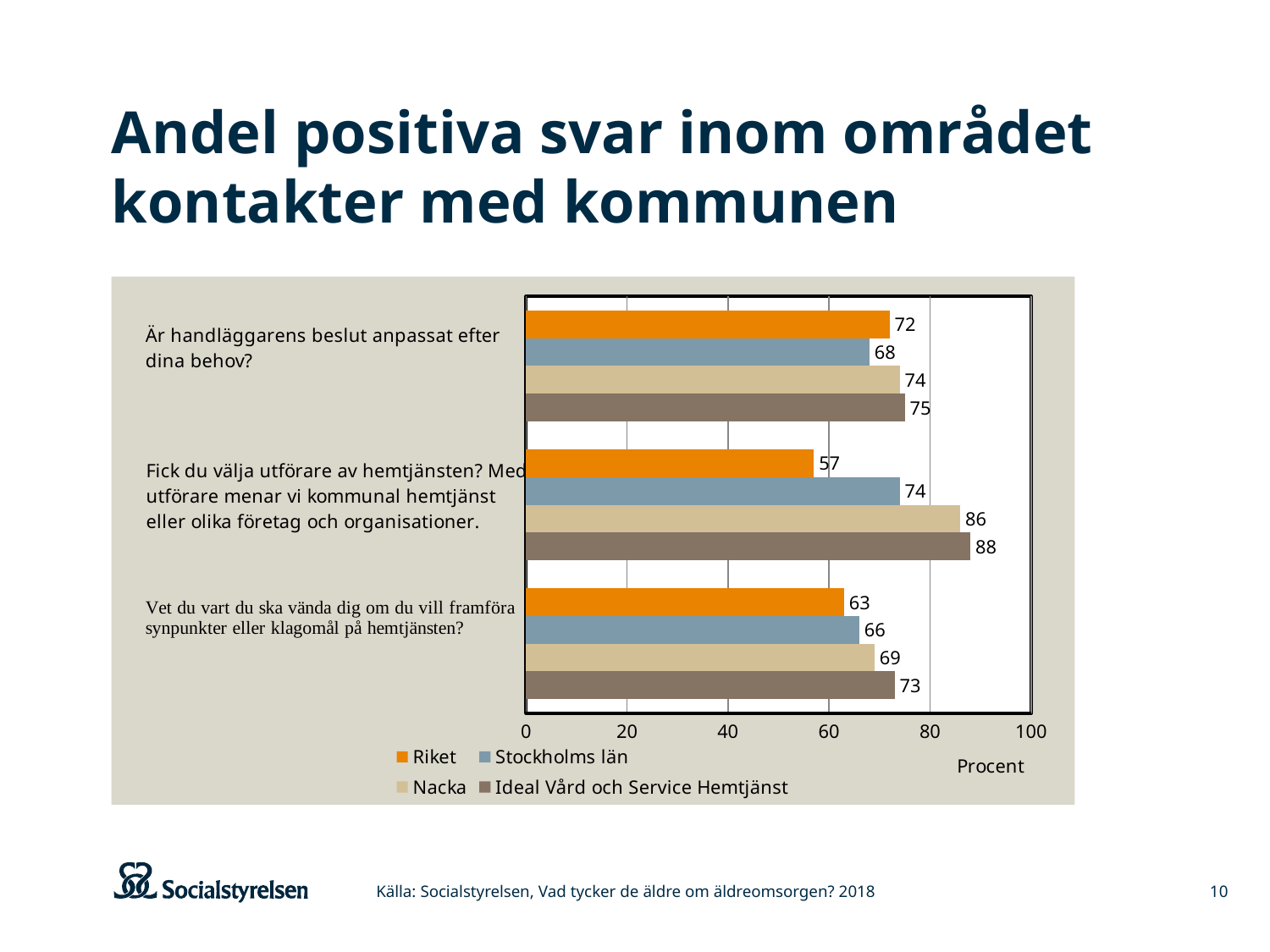
What is the value for Riket on the question "Är handläggarens beslut anpassat efter dina behov?"? 72 What is the value for Nacka on the question "Vet du vart du ska vända dig om du vill framföra synpunkter eller klagomål på hemtjänsten?"? 69 What is the difference between Ideal Vård och Service Hemtjänst and Riket on the question "Fick du välja utförare av hemtjänsten?"? 31 Is the value for Nacka on the question "Fick du välja utförare av hemtjänsten?" greater or less than 80? greater What is the value for Ideal Vård och Service Hemtjänst on the question "Fick du välja utförare av hemtjänsten?"? 88 How many series does the legend list? 4 Which series has the highest value on the question "Fick du välja utförare av hemtjänsten?"? Ideal Vård och Service Hemtjänst How many questions (categories) are shown on the chart? 3 What is the label on the horizontal axis of the chart? Procent Which is larger on the question "Vet du vart du ska vända dig om du vill framföra synpunkter eller klagomål på hemtjänsten?": Riket or Stockholms län? Stockholms län Which series has the lowest value on the question "Är handläggarens beslut anpassat efter dina behov?"? Stockholms län What kind of chart is shown on the slide? Bar chart